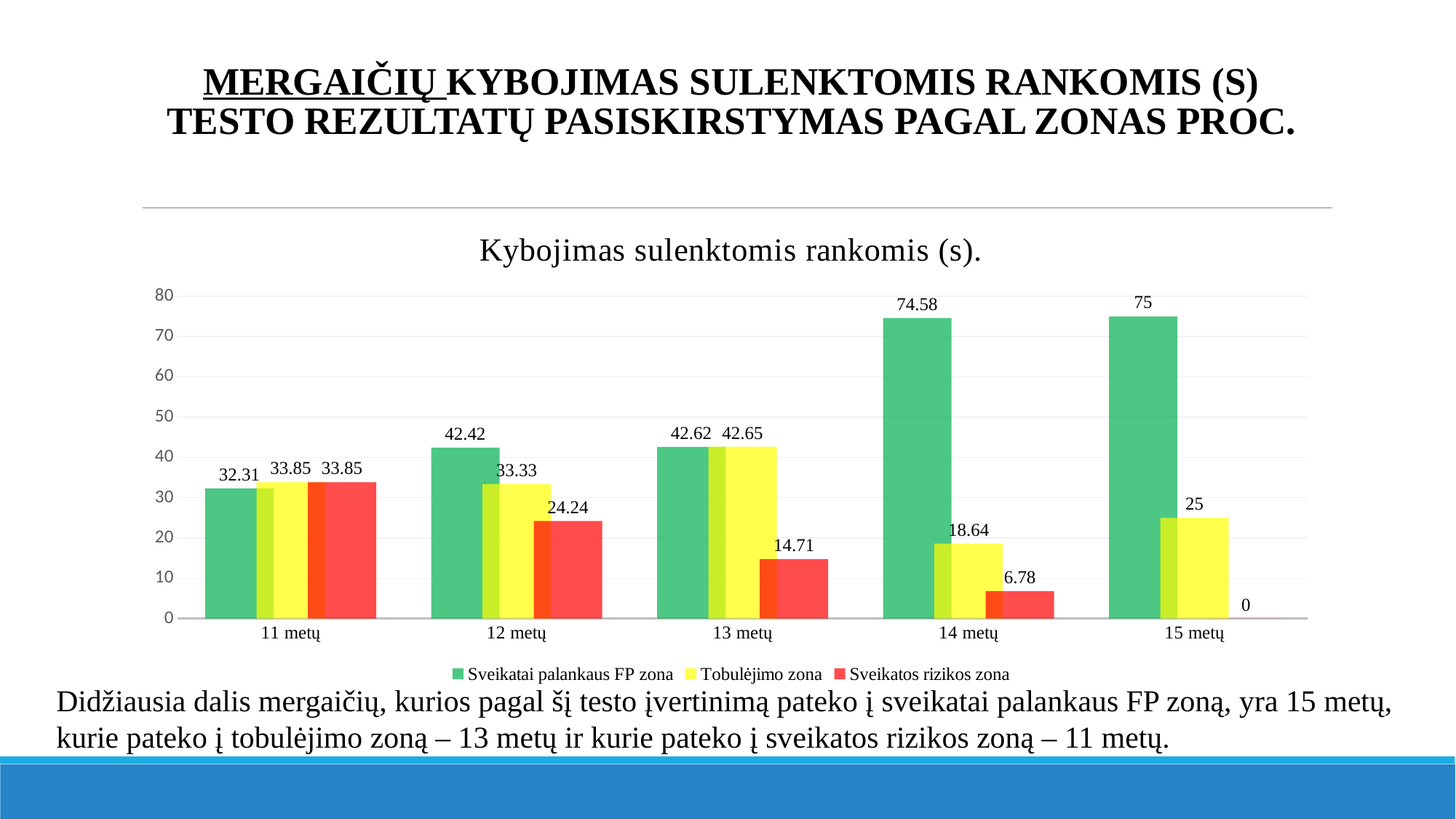
What is the value for Sveikatai palankaus FP zona at 14 metų? 74.58 What is the value for Sveikatos rizikos zona at 12 metų? 24.24 What is the value for Tobulėjimo zona at 15 metų? 25 Do the Sveikatos rizikos zona values rise or fall from 11 metų to 15 metų? Fall How many age groups are shown on the x axis? 5 Which age group has the lowest value for Sveikatos rizikos zona? 15 metų What kind of chart is shown on the slide? Bar chart Which age group has the highest value for Sveikatai palankaus FP zona? 15 metų What is the difference between the Sveikatai palankaus FP zona and Sveikatos rizikos zona values at 14 metų? 67.80 Which is larger at 12 metų: Tobulėjimo zona or Sveikatos rizikos zona? Tobulėjimo zona How many series does the legend list? 3 What is the title of the chart? Kybojimas sulenktomis rankomis (s).